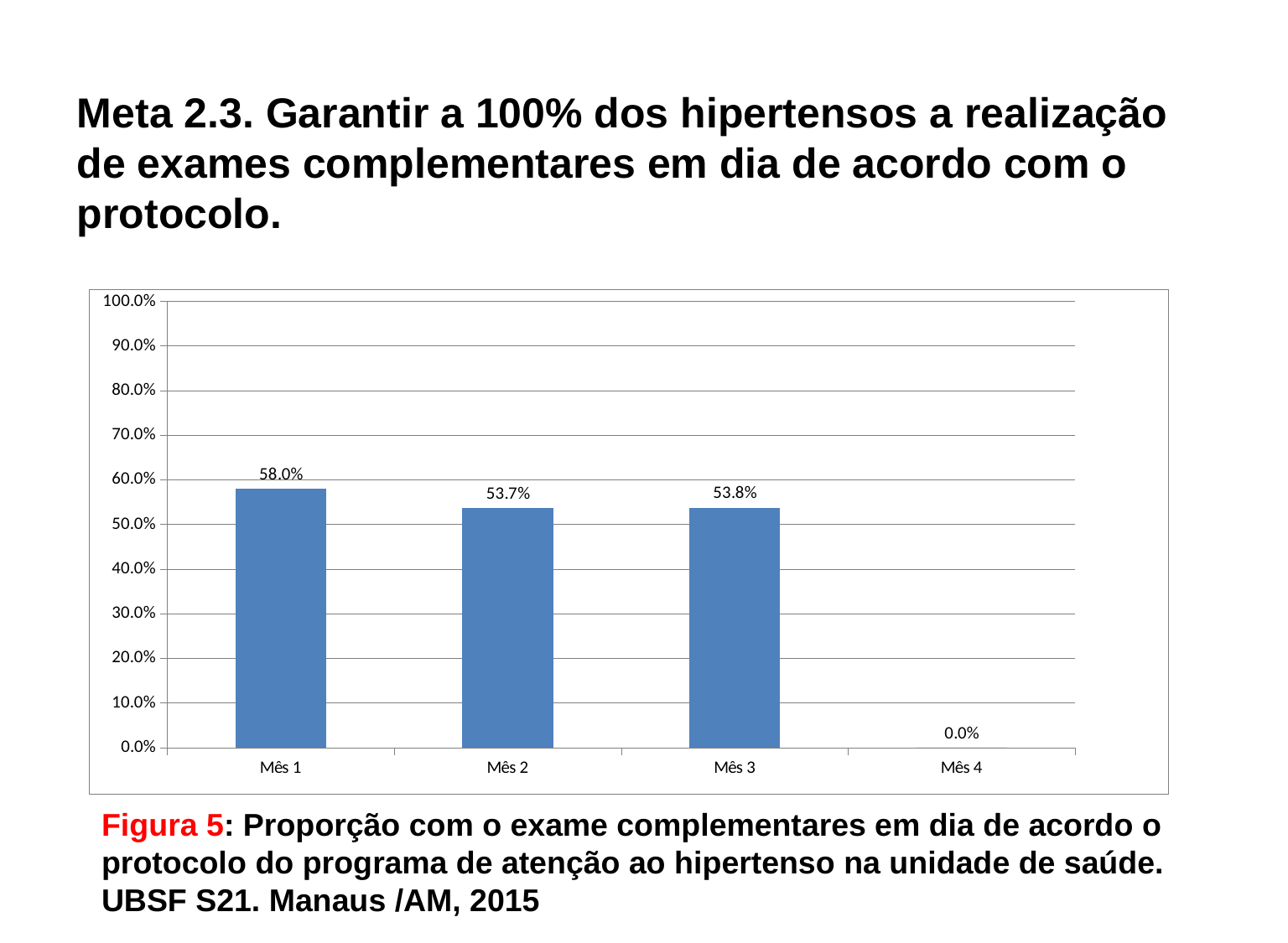
What is the difference between the values for Mês 1 and Mês 2? 4.3% Which month has the highest value? Mês 1 What is the value for Mês 2? 53.7% What is the value for Mês 1? 58.0% Which is larger, the value for Mês 1 or the value for Mês 3? Mês 1 Is the value for Mês 2 greater or less than 60.0%? less What is the value for Mês 3? 53.8% What is the maximum value shown on the y axis? 100.0% How many months are shown on the x axis? 4 Which month has the lowest value? Mês 4 What is the value for Mês 4? 0.0% What kind of chart is shown on the slide? bar chart